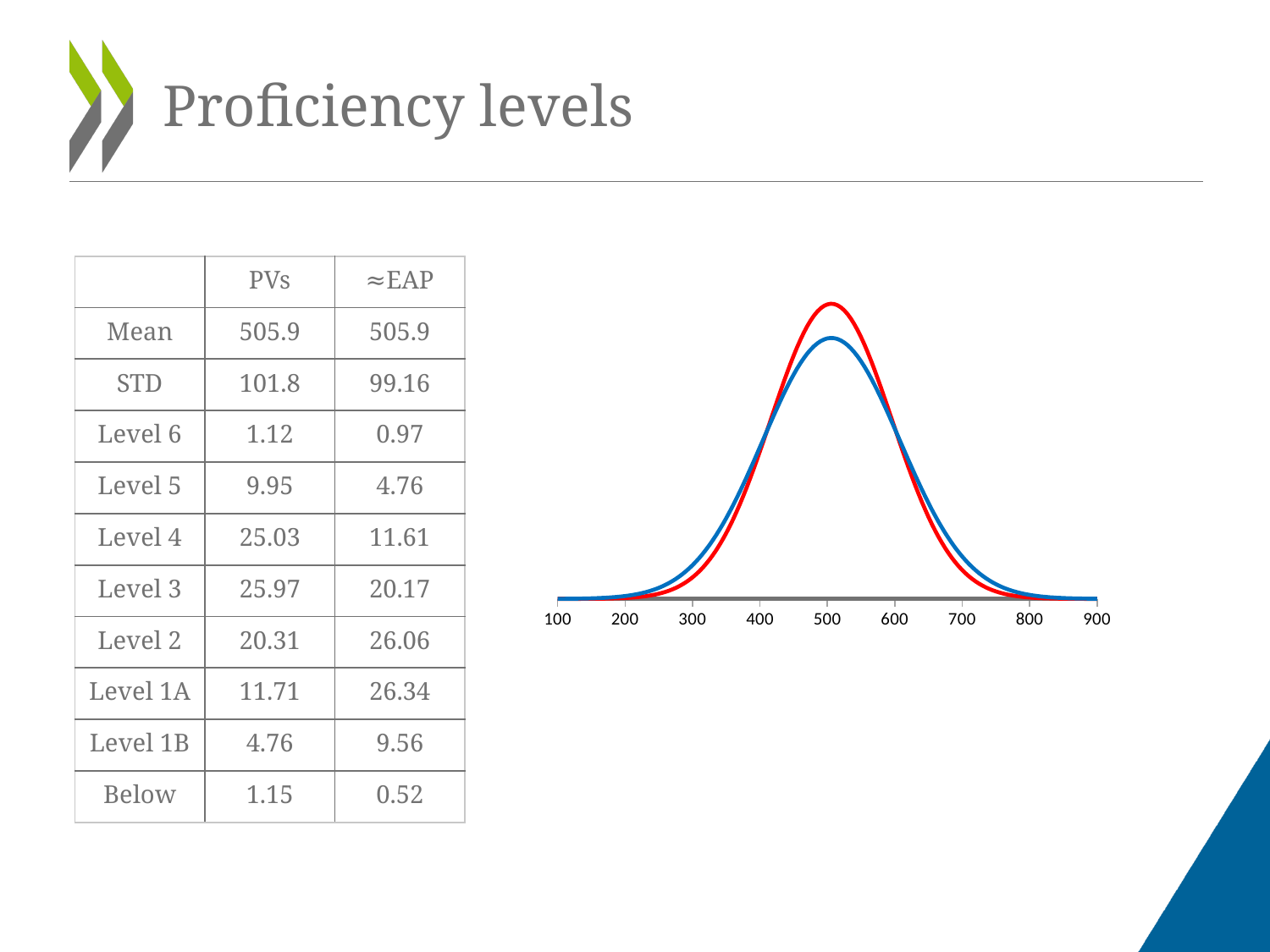
Do the curves rise or fall as x increases from 200 to 500? rise What is the highest value labelled on the x axis of the chart? 900 Which curve reaches the higher peak, the red one or the blue one? red How many curves are plotted on the chart? 2 What colours are the two curves on the chart? red and blue Do the curves rise or fall as x increases from 500 to 800? fall Is the peak of the blue curve located at an x value greater or less than 700? less At x = 700, which curve is higher, the red one or the blue one? blue Is the peak of the red curve located at an x value greater or less than 300? greater How many tick labels are shown on the x axis of the chart? 9 What kind of chart is shown on the right of the slide? line chart